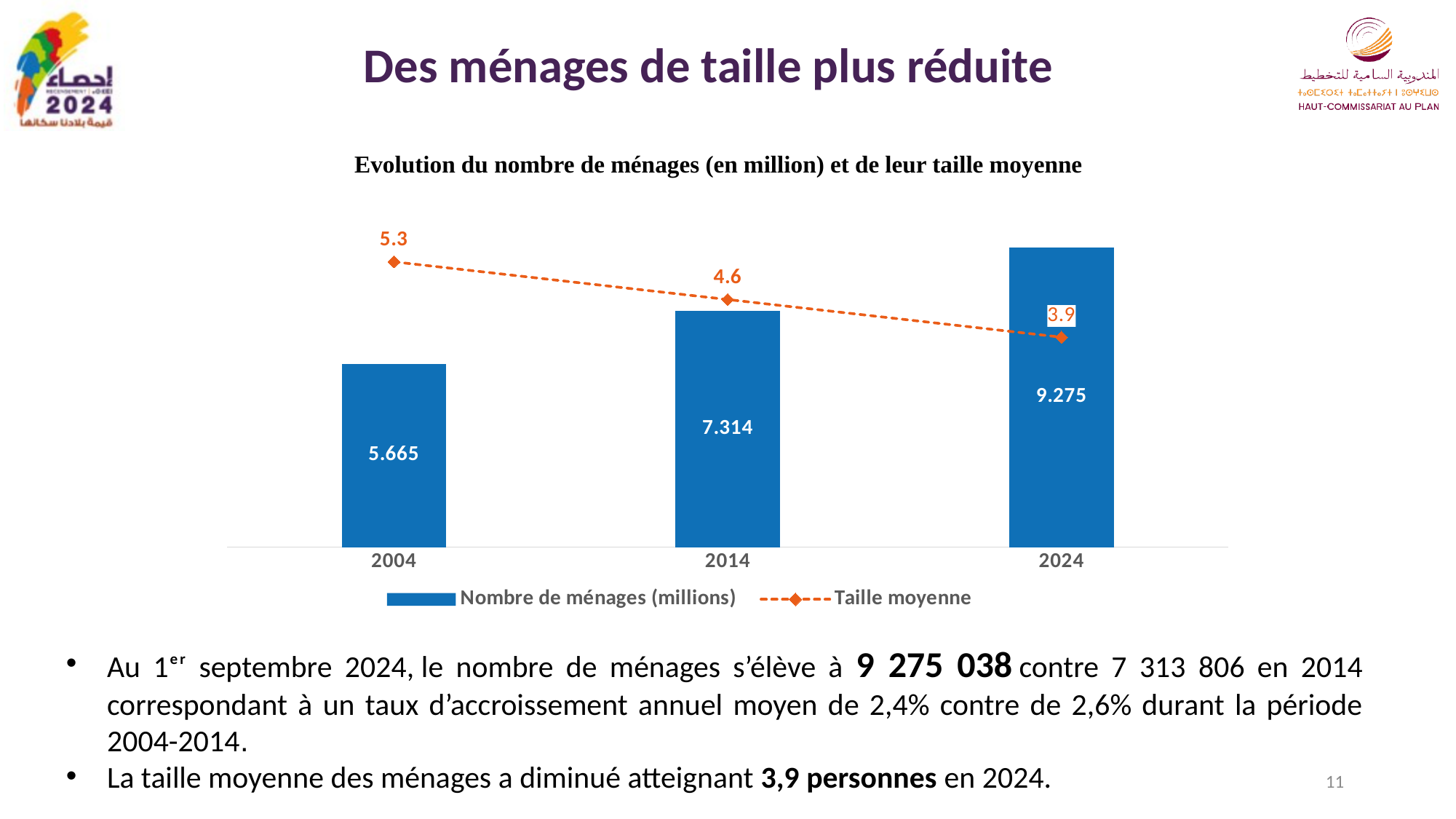
How many series does the legend list? 2 Does the average household size rise or fall from 2004 to 2024? fall Which year has the lowest average household size? 2024 What is the difference in the number of households (millions) between 2024 and 2014? 1.961 What is the number of households (millions) in 2024? 9.275 Is the number of households larger in 2014 or in 2004? 2014 Which year has the highest number of households? 2024 By how much did the average household size fall from 2004 to 2024? 1.4 How many years are shown on the x axis? 3 What is the average household size (Taille moyenne) in 2014? 4.6 What is the average household size (Taille moyenne) in 2024? 3.9 What is the number of households (millions) in 2004? 5.665